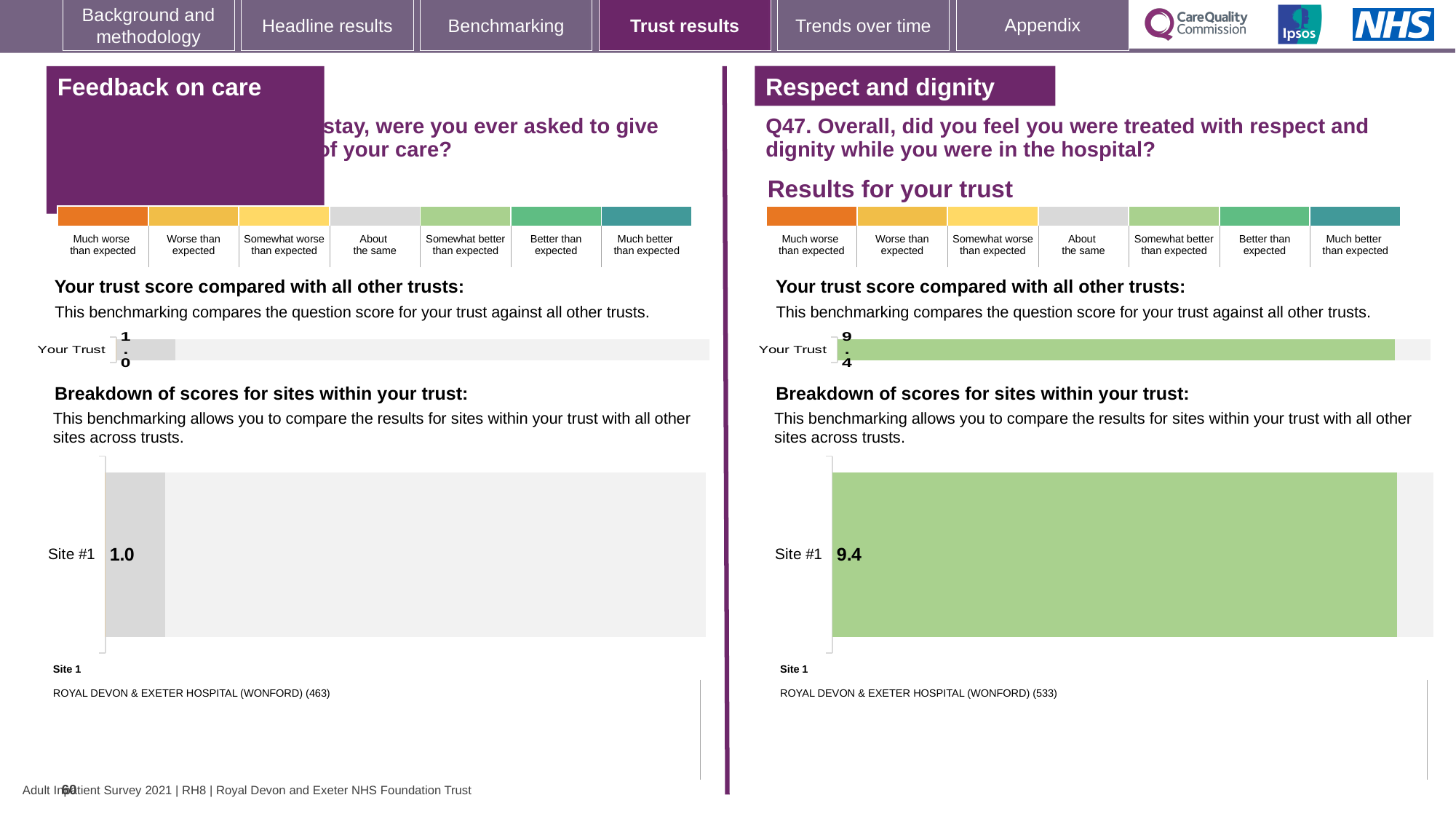
Which is larger: the Site #1 score in the left-hand chart or the Site #1 score in the right-hand chart? The right-hand chart (9.4) In the left-hand 'Breakdown of scores for sites within your trust' chart, what is the score for Site #1? 1.0 In the right-hand 'Breakdown of scores for sites within your trust' chart, what is the score for Site #1? 9.4 On the right-hand 'Respect and dignity' section, what is the score shown for Your Trust? 9.4 How many sites are shown in the left-hand 'Breakdown of scores for sites within your trust' chart? 1 Which site name is listed as Site 1 under the right-hand 'Respect and dignity' chart? ROYAL DEVON & EXETER HOSPITAL (WONFORD) (533) What colour is the Site #1 bar in the left-hand 'Feedback on care' chart? Grey What colour is the Site #1 bar in the right-hand 'Respect and dignity' chart? Green How many sites are shown in the right-hand 'Breakdown of scores for sites within your trust' chart? 1 On the left-hand 'Feedback on care' section, what is the score shown for Your Trust? 1.0 What type of chart is used to show the Site #1 score in the right-hand 'Respect and dignity' section? Bar chart What is the difference between the Site #1 score in the right-hand chart (9.4) and the Site #1 score in the left-hand chart (1.0)? 8.4